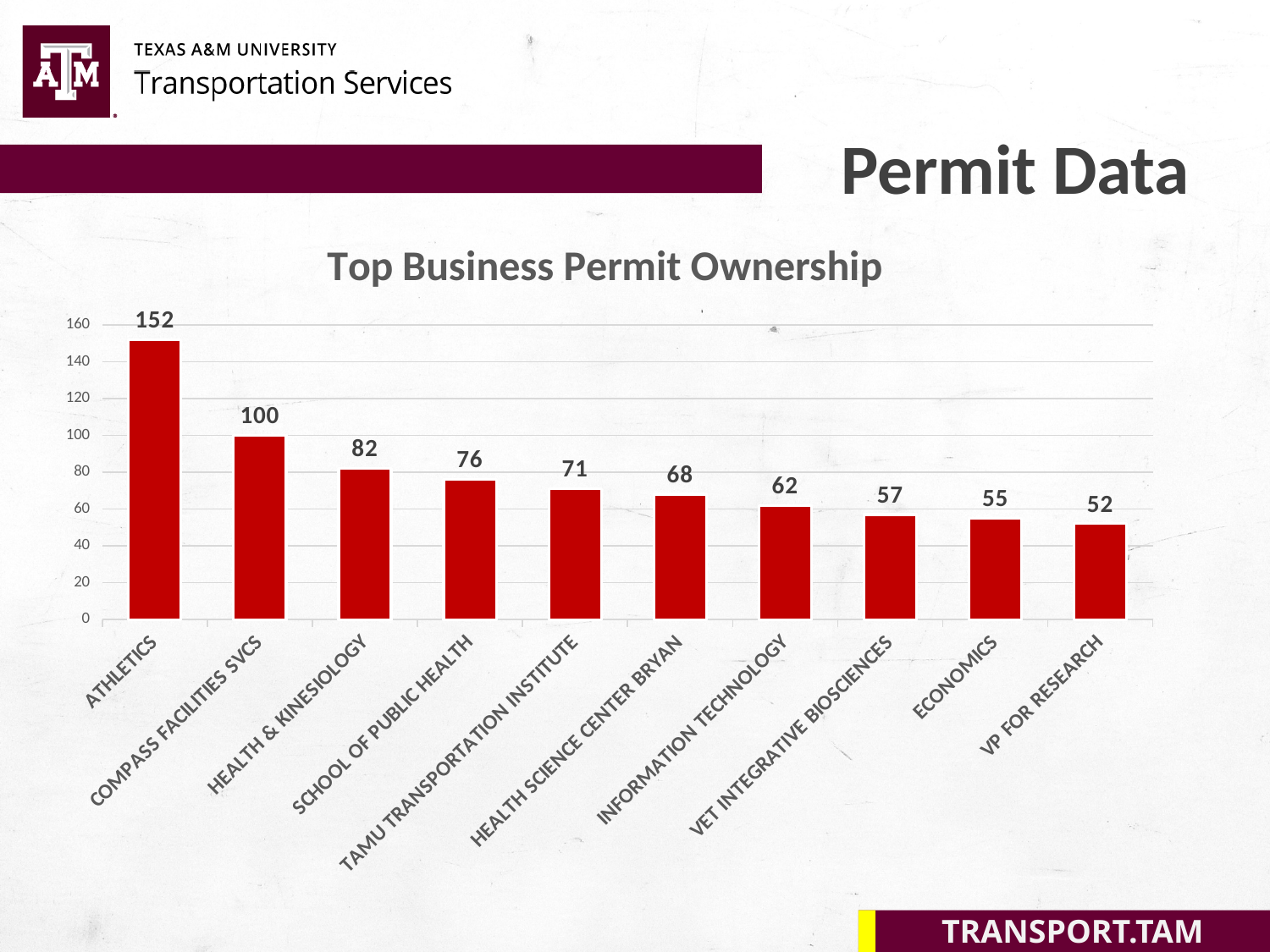
Which is larger, the value for TAMU TRANSPORTATION INSTITUTE or the value for VET INTEGRATIVE BIOSCIENCES? TAMU TRANSPORTATION INSTITUTE How many categories are shown in the chart? 10 What is the value for INFORMATION TECHNOLOGY? 62 Is the value for HEALTH SCIENCE CENTER BRYAN greater or less than 80? less What is the value for HEALTH & KINESIOLOGY? 82 What is the title of the chart? Top Business Permit Ownership What kind of chart is shown on the slide? bar chart Which category has the lowest value? VP FOR RESEARCH What is the difference between the values for SCHOOL OF PUBLIC HEALTH and ECONOMICS? 21 What is the value for ATHLETICS? 152 Which category has the highest value? ATHLETICS What is the difference between the values for ATHLETICS and COMPASS FACILITIES SVCS? 52